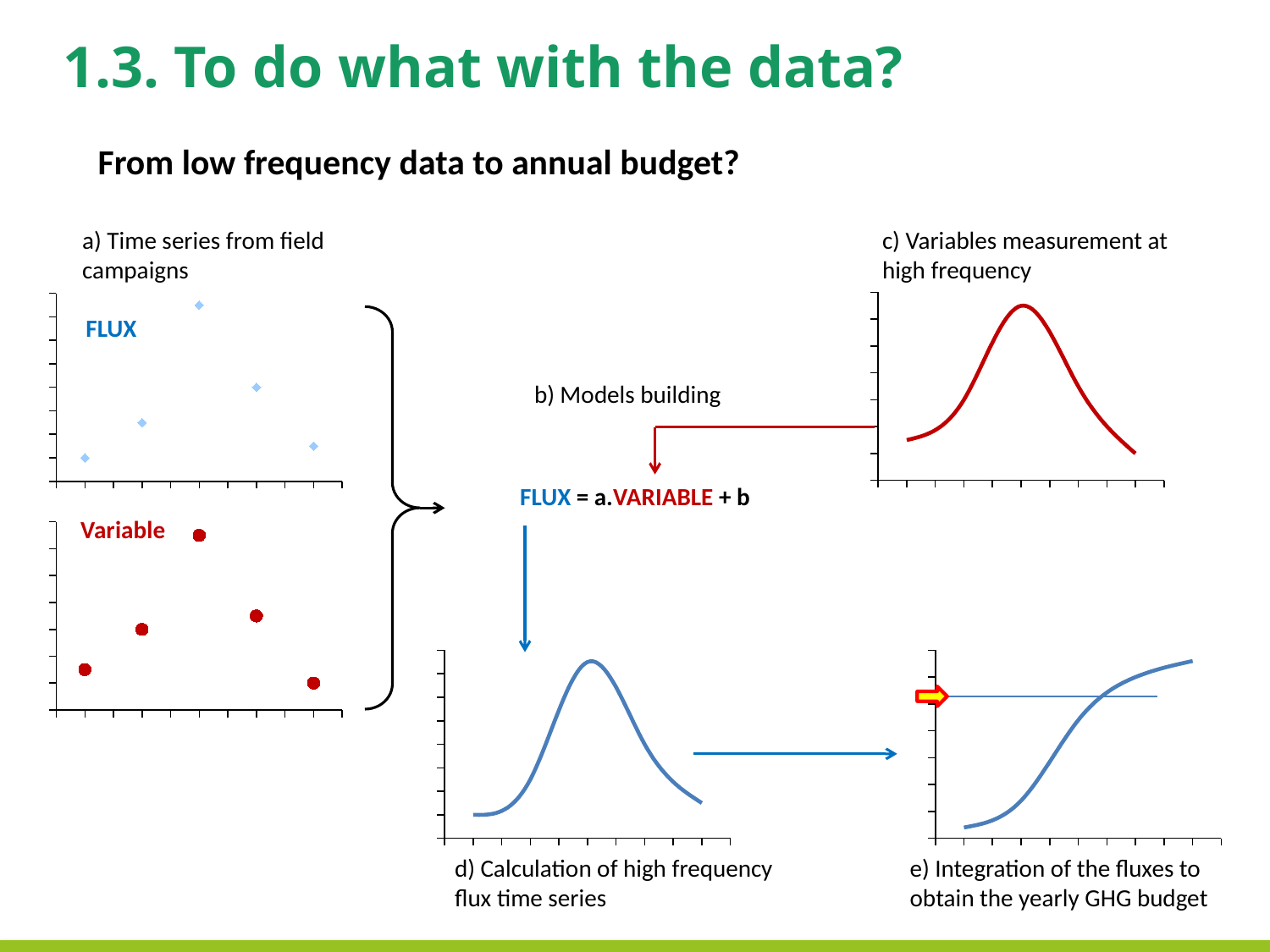
What kind of chart is the top-left chart labelled FLUX? scatter chart How many data points are plotted in the Variable chart on the left? 5 In the chart 'e) Integration of the fluxes to obtain the yearly GHG budget', do the values rise or fall along the x axis? rise What kind of chart is the chart under 'c) Variables measurement at high frequency'? line chart In the Variable chart on the left, which point has the highest value? the third point from the left What series label is shown inside the top-left scatter chart? FLUX How many data points are plotted in the top-left FLUX chart? 5 What colour is the line in the chart 'c) Variables measurement at high frequency'? red In the top-left FLUX chart, which point has the highest value? the third point from the left In the chart 'd) Calculation of high frequency flux time series', how do the values change along the x axis? rise then fall How many charts are shown on the slide? 5